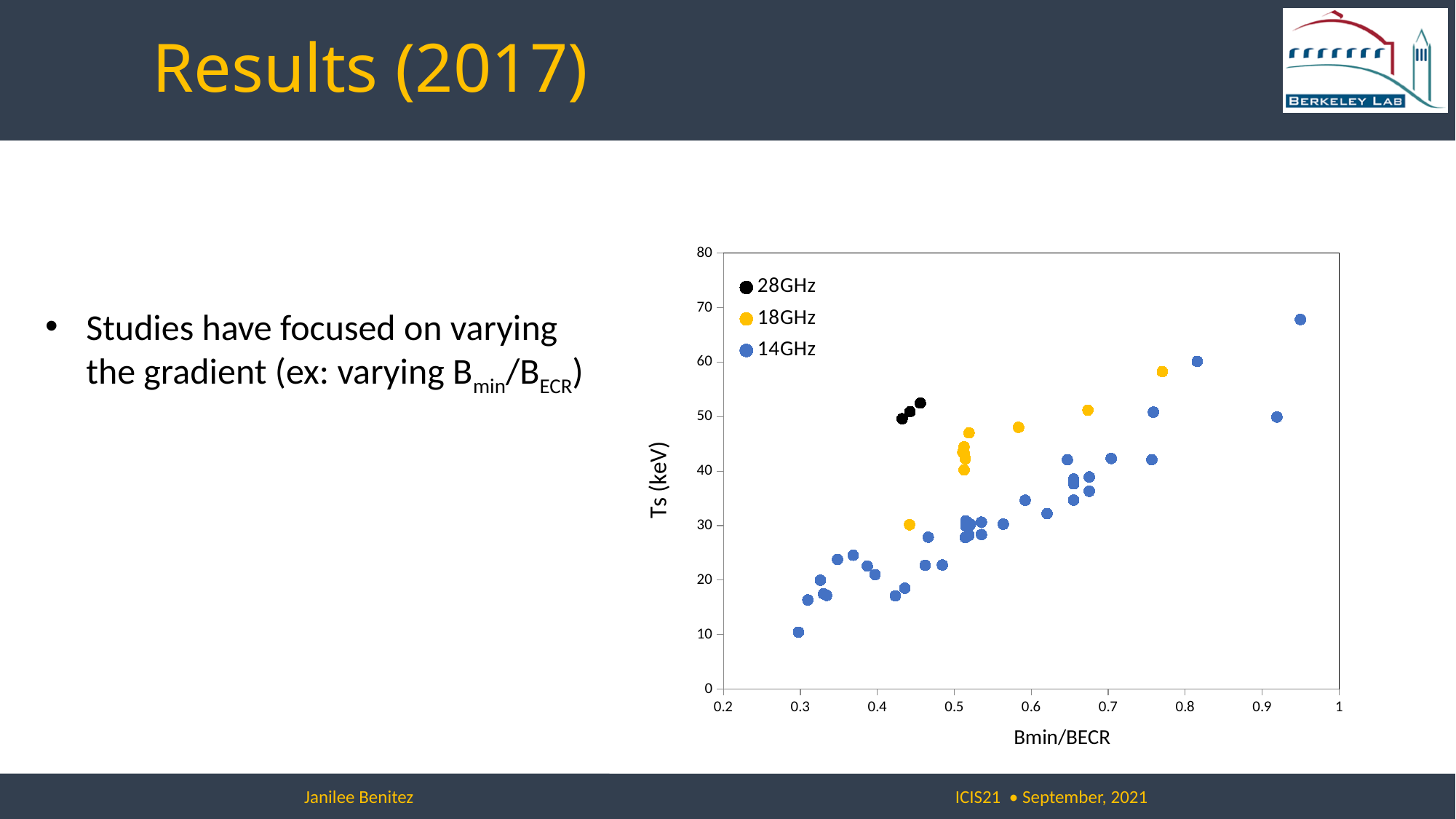
Which series contains the point with the highest Ts value? 14GHz How many series does the legend list? 3 What is the label of the y axis? Ts (keV) Is the Ts value of the highest 18GHz point greater or less than 50? greater What kind of chart is shown on the slide? Scatter chart Is the Ts value of the highest 14GHz point greater or less than 60? greater Which series has points at higher Ts values around Bmin/BECR of 0.45: 28GHz or 18GHz? 28GHz Is the Ts value of the lowest 14GHz point greater or less than 20? less Which series contains the point with the lowest Ts value? 14GHz Do the Ts values generally rise or fall as Bmin/BECR increases? Rise Which series are listed in the chart legend? 28GHz, 18GHz, 14GHz